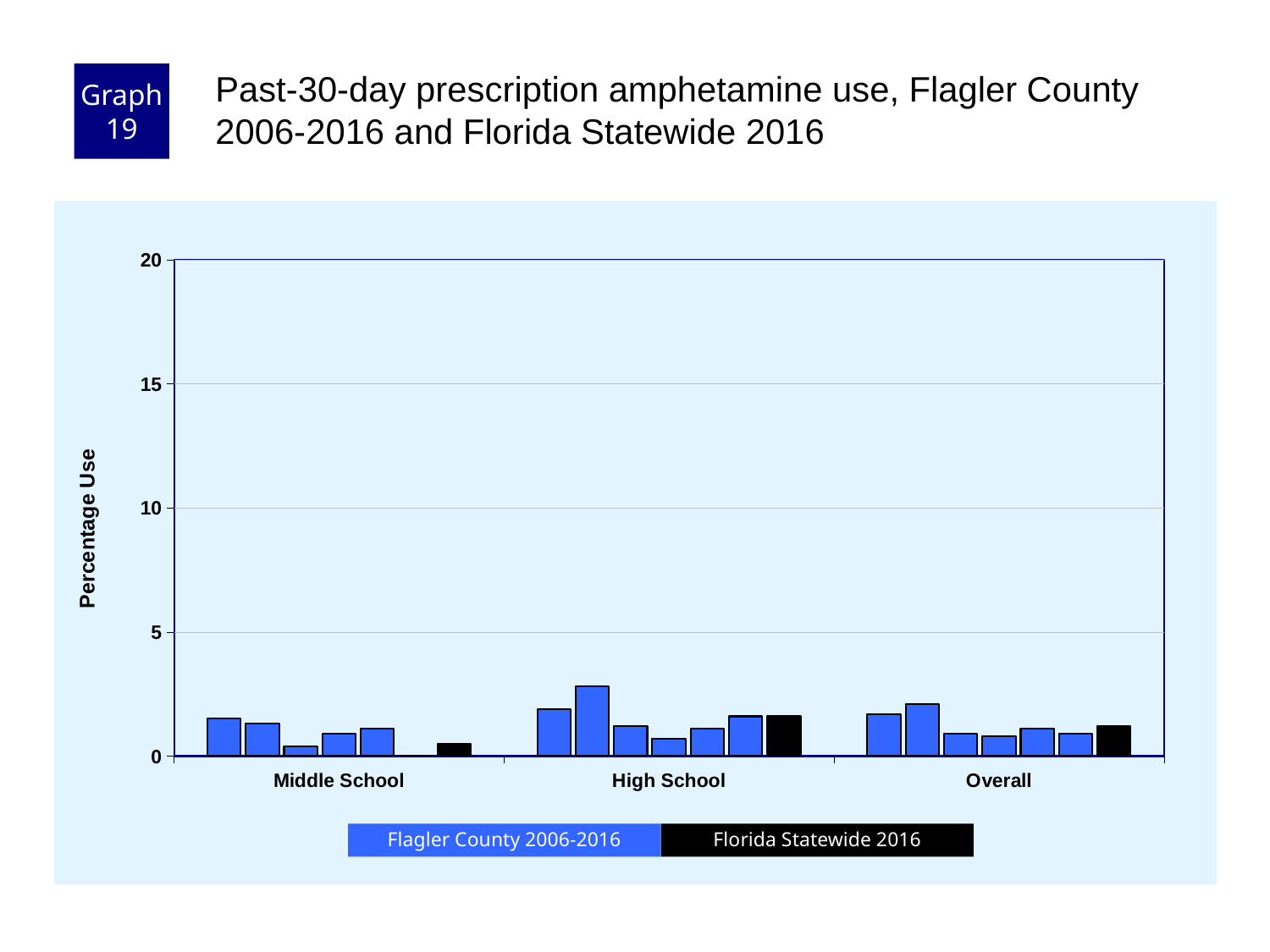
Is the tallest Flagler County bar in the High School group greater or less than 5? less Which is larger, the Florida Statewide 2016 value for High School or for Middle School? High School Is the Florida Statewide 2016 value for High School greater or less than 5? less How many series does the legend list? 2 Which category group has the lowest Florida Statewide 2016 value? Middle School Is the Florida Statewide 2016 value for Middle School greater or less than 5? less Which category group contains the tallest bar on the chart? High School Which colour represents Florida Statewide 2016 in the legend? black How many category groups are shown on the x axis? 3 What kind of chart is shown on the slide? bar chart Which is larger, the Florida Statewide 2016 value for Overall or for Middle School? Overall What is the label of the y axis? Percentage Use